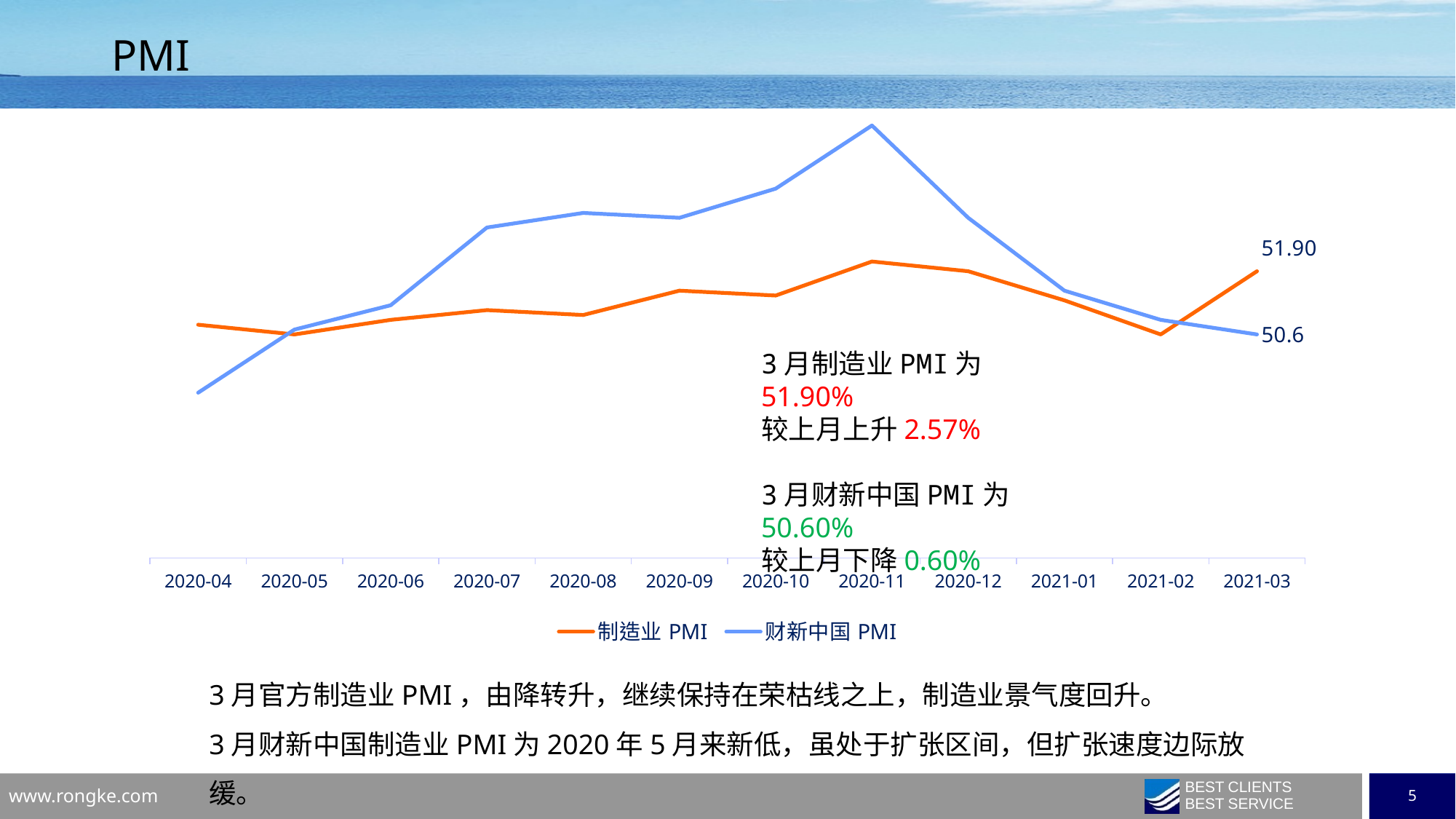
What is the difference between 制造业 PMI and 财新中国 PMI in 2021-03? 1.30 How many months are plotted along the x axis? 12 Does 财新中国 PMI rise or fall from 2020-11 to 2021-03? fall What is the value of 制造业 PMI for 2021-03? 51.90 Which series has the higher value in 2021-03, 制造业 PMI or 财新中国 PMI? 制造业 PMI In which month does 财新中国 PMI reach its highest value? 2020-11 How many series does the legend list? 2 What is the value of 财新中国 PMI for 2021-03? 50.6 What type of chart is shown on the slide? line chart In which month does 财新中国 PMI have its lowest value? 2020-04 What colour is the 制造业 PMI line? orange Which series is higher in 2020-11, 制造业 PMI or 财新中国 PMI? 财新中国 PMI